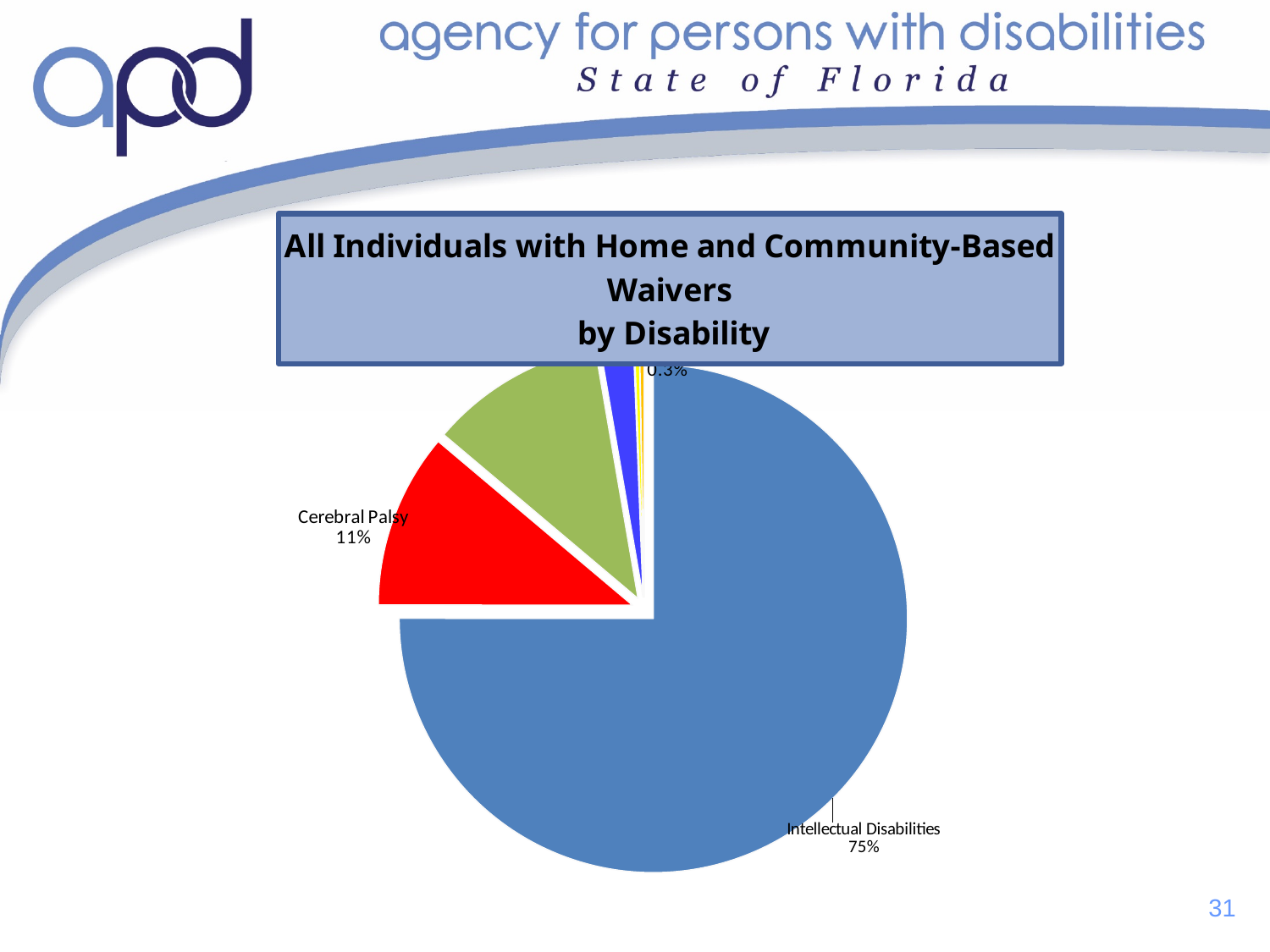
Which disability category has the largest share of the pie chart? Intellectual Disabilities What is the title of the chart? All Individuals with Home and Community-Based Waivers by Disability What percentage of the pie chart is Intellectual Disabilities? 75% What percentage of the pie chart is Cerebral Palsy? 11% Which is larger, the share for Intellectual Disabilities or the share for Cerebral Palsy? Intellectual Disabilities What kind of chart is shown on the slide? Pie chart How many percentage points larger is the Intellectual Disabilities share than the Cerebral Palsy share? 64 percentage points What colour is the Cerebral Palsy slice in the pie chart? Red What share of the pie does the Intellectual Disabilities slice represent? 75%